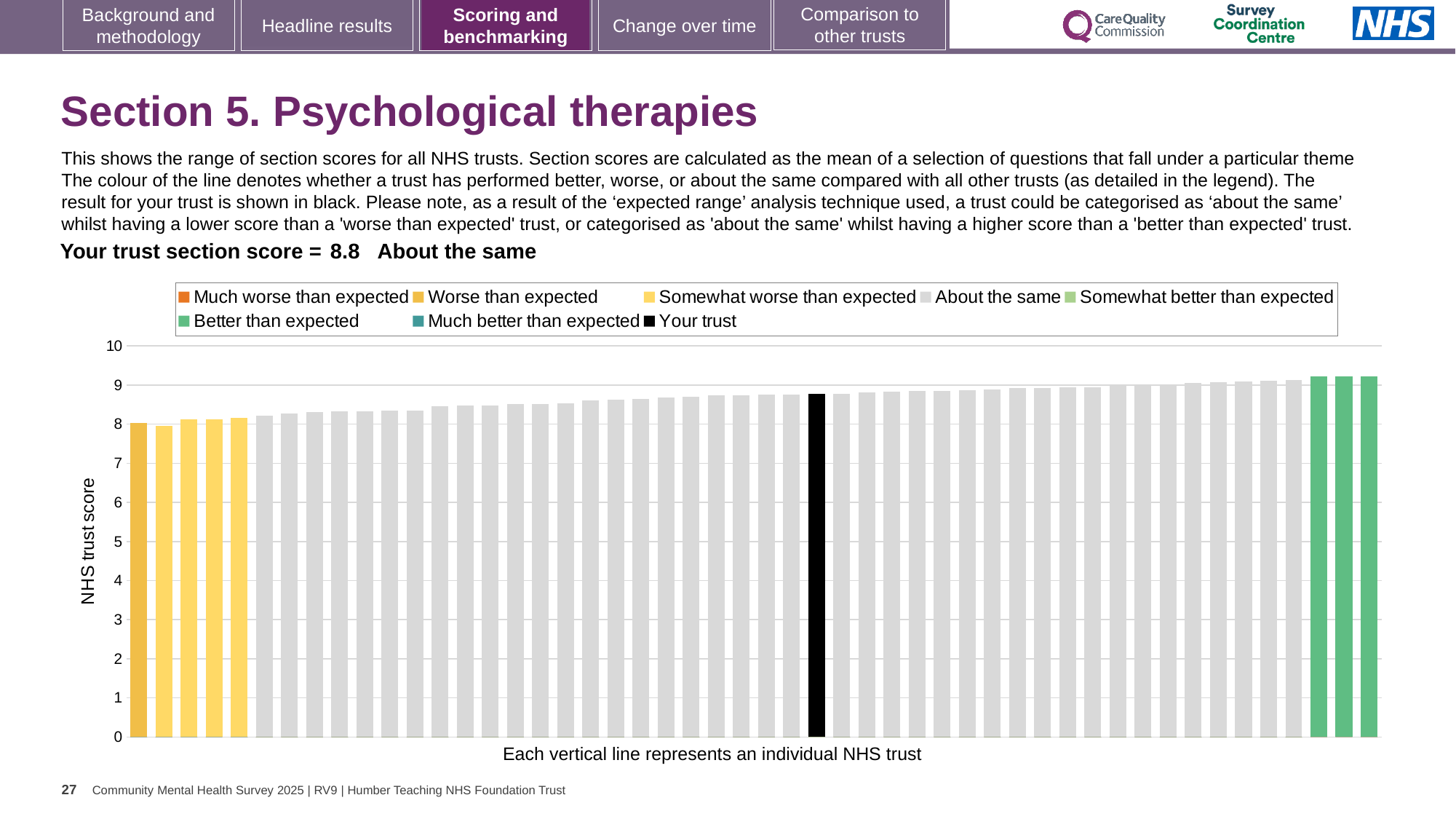
Do the bar values rise or fall from left to right along the x axis? rise Is the value for the rightmost bar greater or less than 9? greater Is the value for the black 'Your trust' bar greater or less than 8? greater Is the value for the leftmost bar greater or less than 9? less How many black 'Your trust' bars are shown in the chart? 1 Which is larger: the value for the black 'Your trust' bar or the value for the leftmost bar? Your trust What is the section score for your trust shown on the slide? 8.8 How many green 'Better than expected' bars are shown in the chart? 3 Which category is your trust placed in according to the slide? About the same What kind of chart is shown on the slide? bar chart What is the label on the y axis of the chart? NHS trust score How many entries does the chart legend list? 8